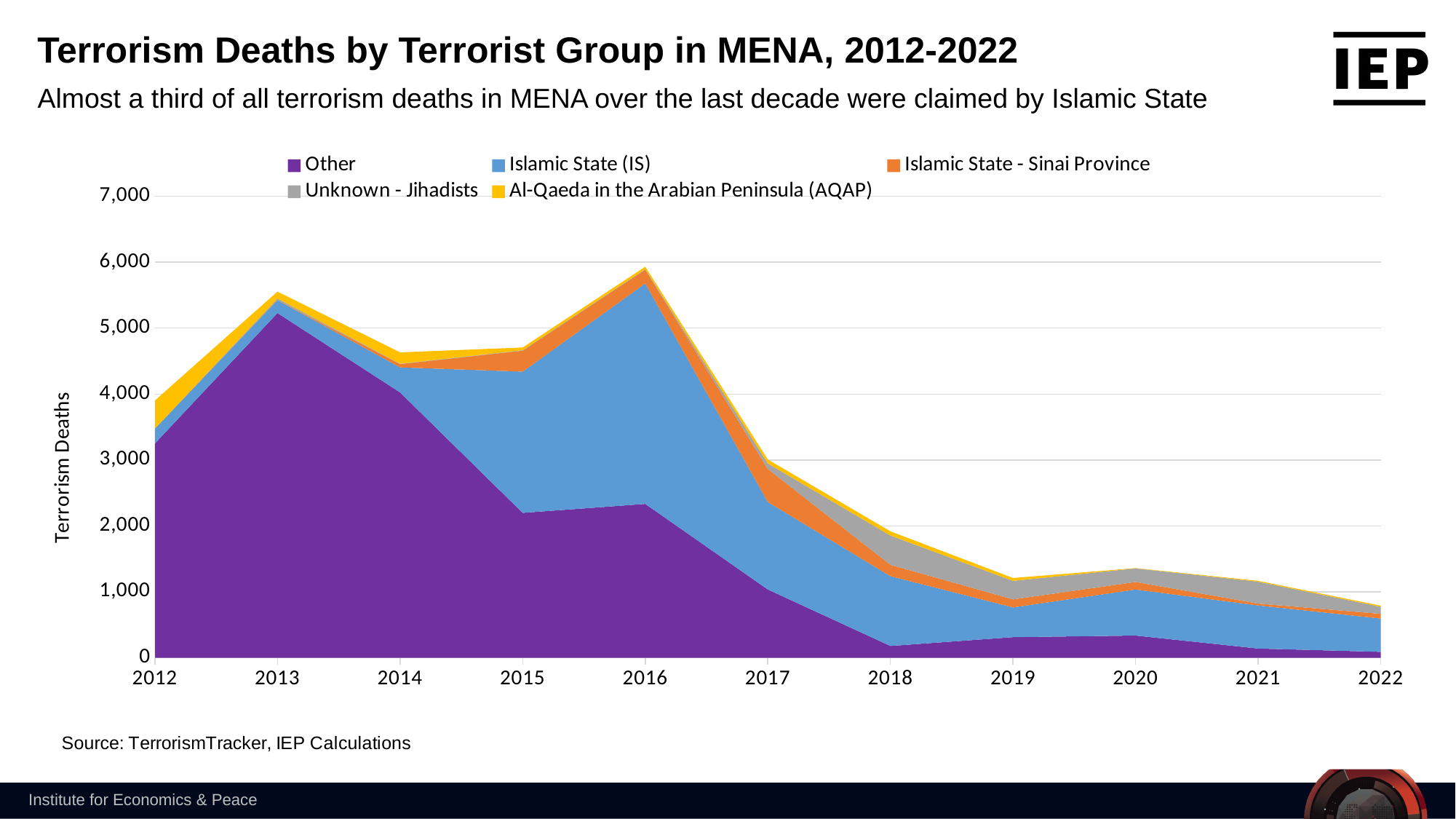
Is the total terrorism deaths in 2017 greater or less than 4,000? less How many years are shown along the x axis? 11 Is the value for the Other series in 2018 greater or less than 500? less Do total terrorism deaths rise or fall from 2016 to 2022? fall Which year has the highest total terrorism deaths? 2016 Is the total terrorism deaths in 2016 greater or less than 5,000? greater What is the label on the y axis? Terrorism Deaths Which is larger, the total terrorism deaths in 2012 or in 2019? 2012 What kind of chart is shown on the slide? Stacked area chart Which year has the lowest total terrorism deaths? 2022 How many series does the legend list? 5